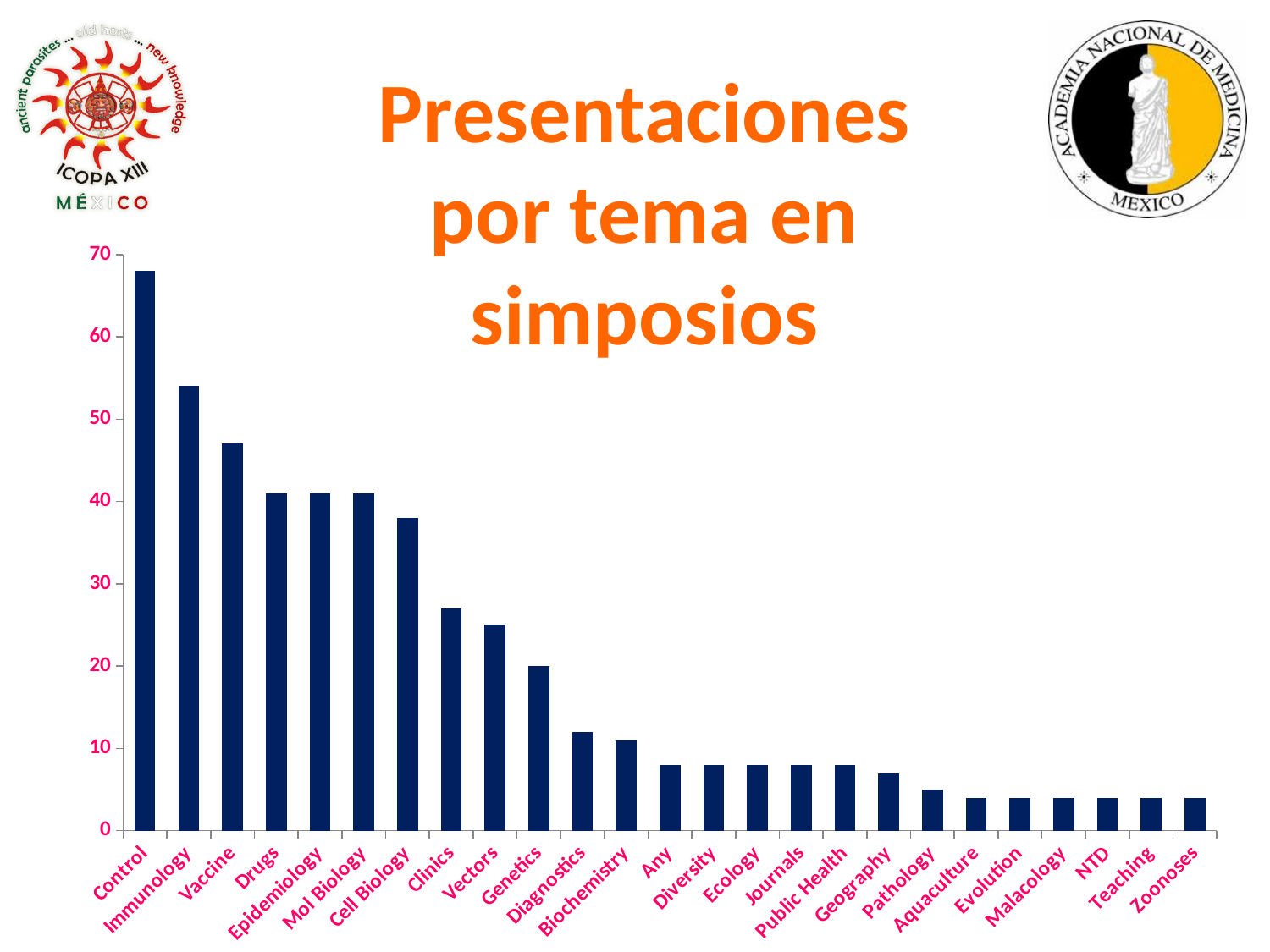
Is the value for Immunology greater or less than 50? greater Is the value for Vaccine greater or less than 50? less Is the value for Clinics greater or less than 30? less Which is larger, the value for Vaccine or the value for Vectors? Vaccine Which category has the highest value in the chart? Control What is the title of the slide containing the chart? Presentaciones por tema en simposios How many categories are plotted along the x axis? 25 Do the values generally rise or fall from left to right along the x axis? fall What kind of chart is shown on the slide? bar chart